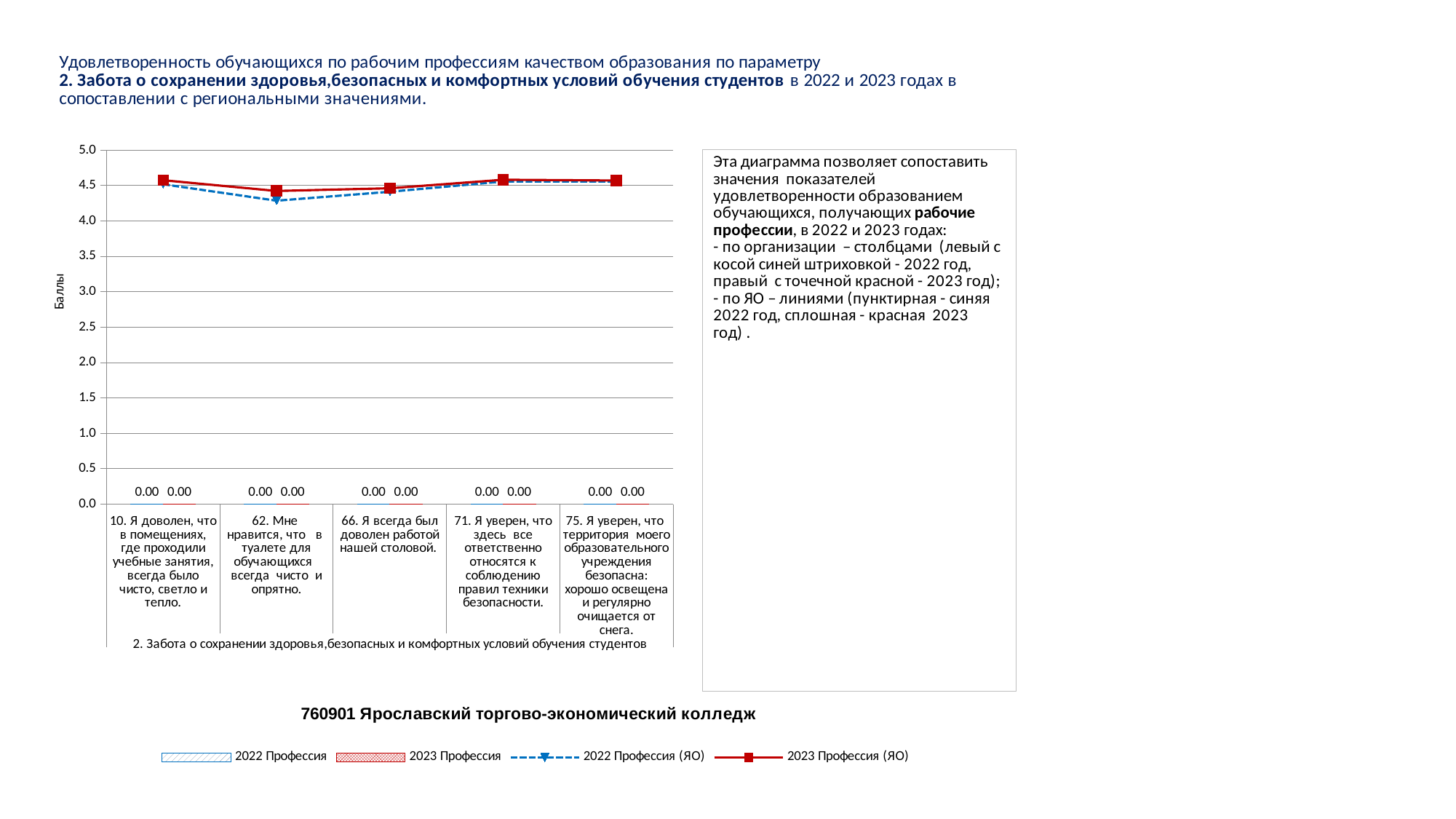
Is the value of the 2023 Профессия (ЯО) line for the category "10. Я доволен, что в помещениях..." greater or less than 4.0? greater For the category "62. Мне нравится, что в туалете...", which line is higher: 2022 Профессия (ЯО) or 2023 Профессия (ЯО)? 2023 Профессия (ЯО) What is the label of the vertical axis of the chart? Баллы Does the 2022 Профессия (ЯО) line rise or fall from category 62 to category 71? rise How many series does the chart legend list? 4 For which category does the 2022 Профессия (ЯО) line reach its lowest value? 62. Мне нравится, что в туалете для обучающихся всегда чисто и опрятно. What kind of chart is shown on the slide? Combined bar and line chart Which series in the legend is drawn as a solid red line with square markers? 2023 Профессия (ЯО) Is the value of the 2022 Профессия (ЯО) line for the category "62. Мне нравится, что в туалете для обучающихся всегда чисто и опрятно." greater or less than 4.5? less What is the value of the 2023 Профессия series for the category "66. Я всегда был доволен работой нашей столовой."? 0.00 How many categories (survey statements) are shown on the x axis of the chart? 5 What is the value of the 2022 Профессия series for the category "10. Я доволен, что в помещениях, где проходили учебные занятия, всегда было чисто, светло и тепло."? 0.00